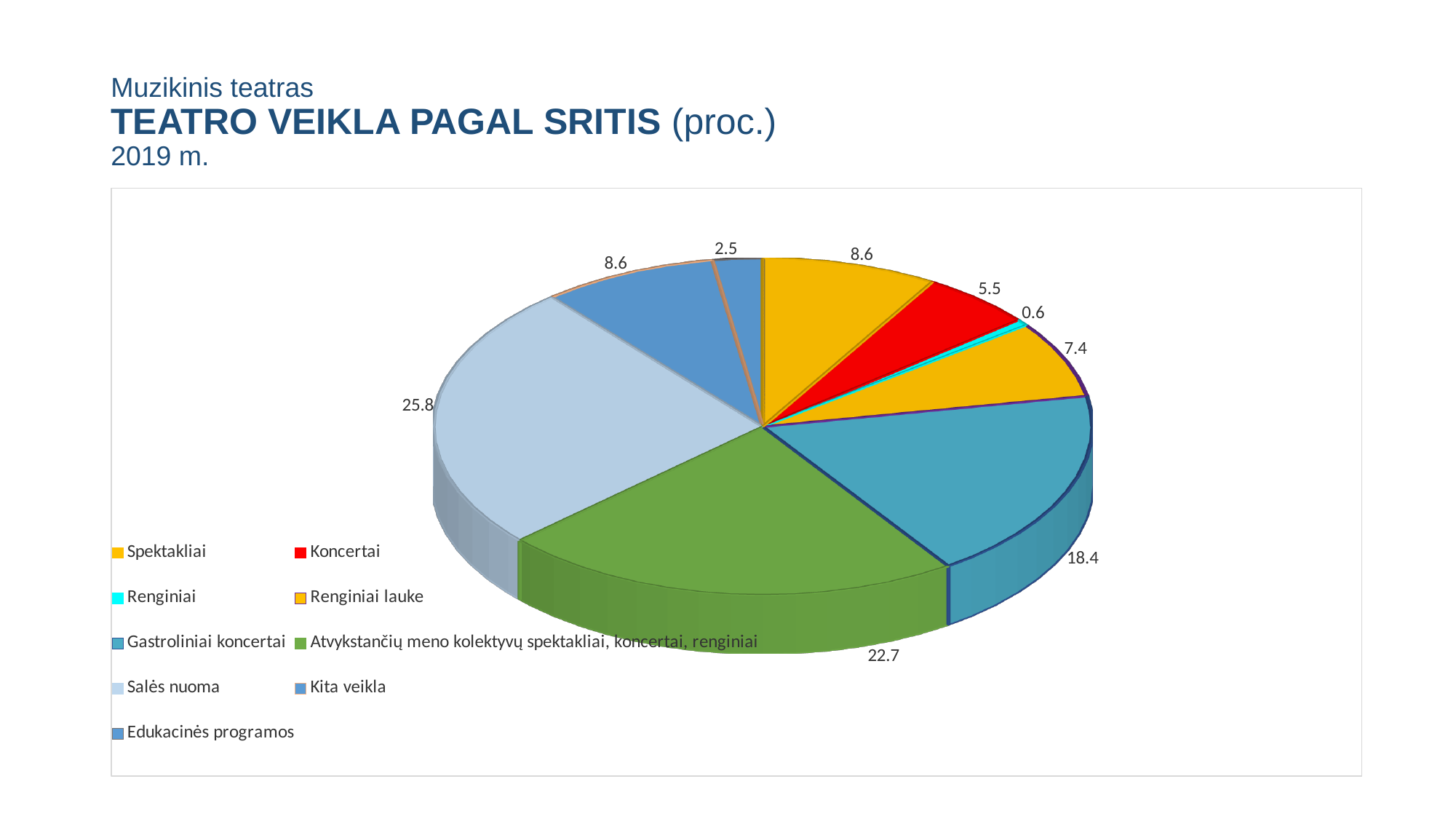
What is the value for Renginiai? 0.6 What is the value for Edukacinės programos? 2.5 Which is larger, the value for Koncertai or the value for Renginiai lauke? Renginiai lauke What is the value for Gastroliniai koncertai? 18.4 What type of chart is shown on the slide? pie chart How many categories does the legend list? 9 What is the difference between the values for Salės nuoma and Gastroliniai koncertai? 7.4 Which category has the largest share of the pie? Salės nuoma What is the value for Koncertai? 5.5 What is the value for Salės nuoma? 25.8 Which category has the smallest share of the pie? Renginiai What is the value for Atvykstančių meno kolektyvų spektakliai, koncertai, renginiai? 22.7